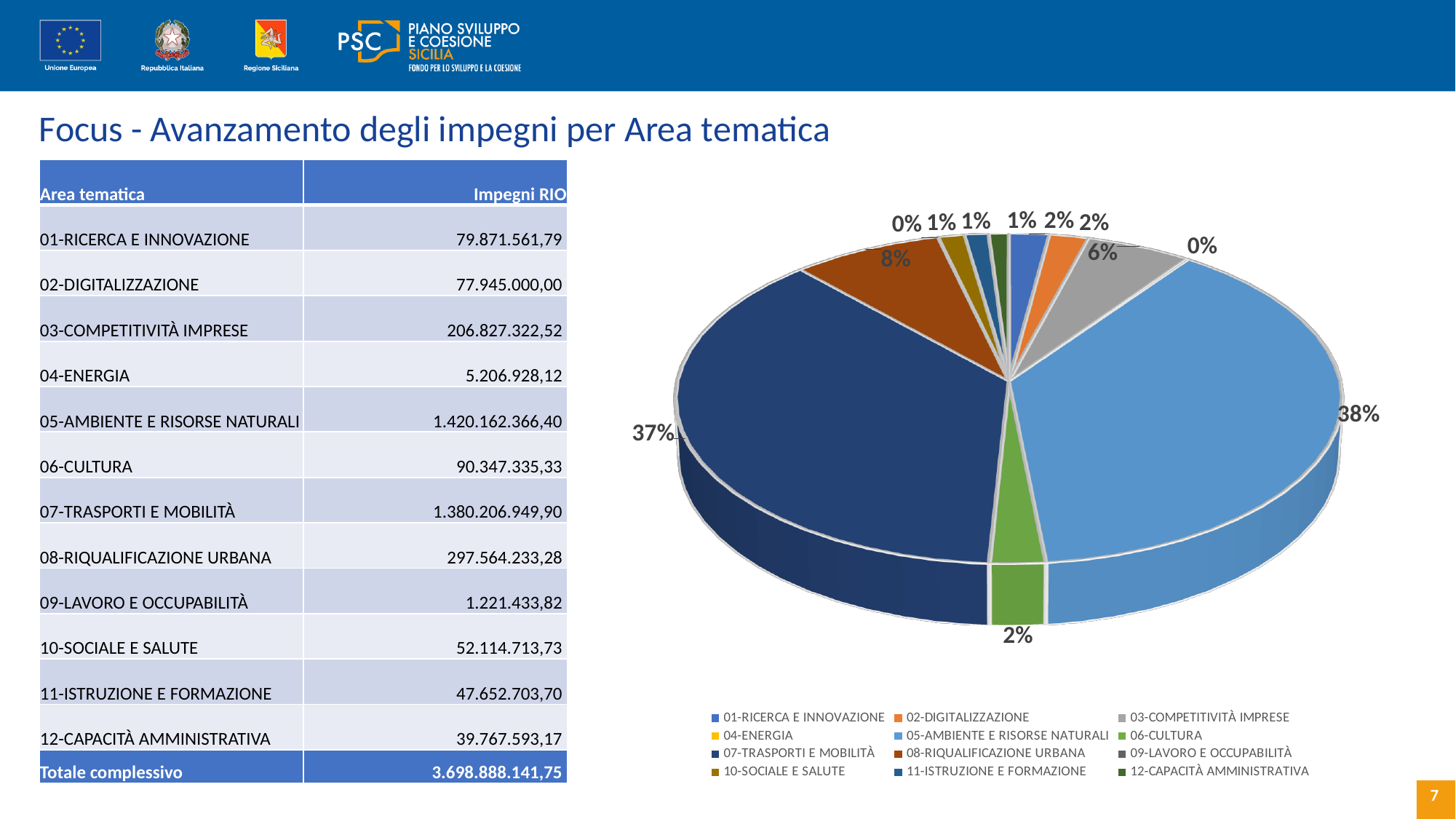
What share of the pie does 03-COMPETITIVITÀ IMPRESE represent? 6% What is the difference in percentage points between the 05-AMBIENTE E RISORSE NATURALI slice and the 07-TRASPORTI E MOBILITÀ slice? 1 percentage point What share of the pie does 08-RIQUALIFICAZIONE URBANA represent? 8% What share of the pie does 07-TRASPORTI E MOBILITÀ represent? 37% How many slices (categories) does the pie chart have? 12 Which slice is larger, 05-AMBIENTE E RISORSE NATURALI or 07-TRASPORTI E MOBILITÀ? 05-AMBIENTE E RISORSE NATURALI What is the title of the slide containing the pie chart? Focus - Avanzamento degli impegni per Area tematica What kind of chart is shown on the slide? pie chart How many entries does the legend of the pie chart list? 12 Which category has the largest slice of the pie chart? 05-AMBIENTE E RISORSE NATURALI